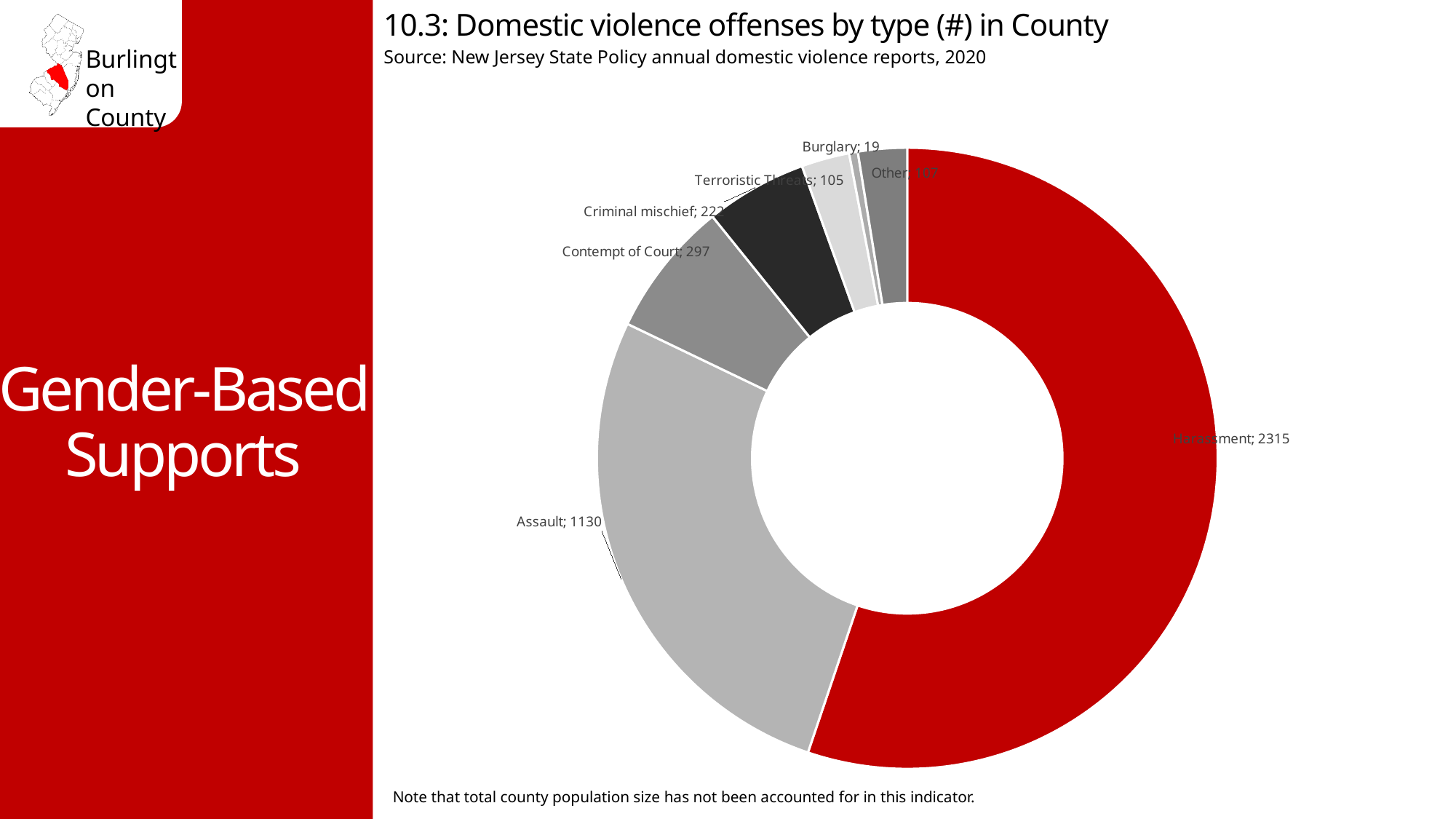
What is the number of Assault offenses shown on the chart? 1130 Which offense type has the highest number of offenses? Harassment Which offense type has the lowest number of offenses? Burglary What value is shown for Burglary? 19 What value is shown for Criminal mischief? 222 What kind of chart is shown on the slide? Doughnut (pie) chart What is the number of Harassment offenses shown on the chart? 2315 What is the difference between the Harassment and Assault values? 1185 What value is shown for Terroristic Threats? 105 How many offense categories are shown on the chart? 7 What value is shown for Contempt of Court? 297 Which is larger, Contempt of Court or Criminal mischief? Contempt of Court